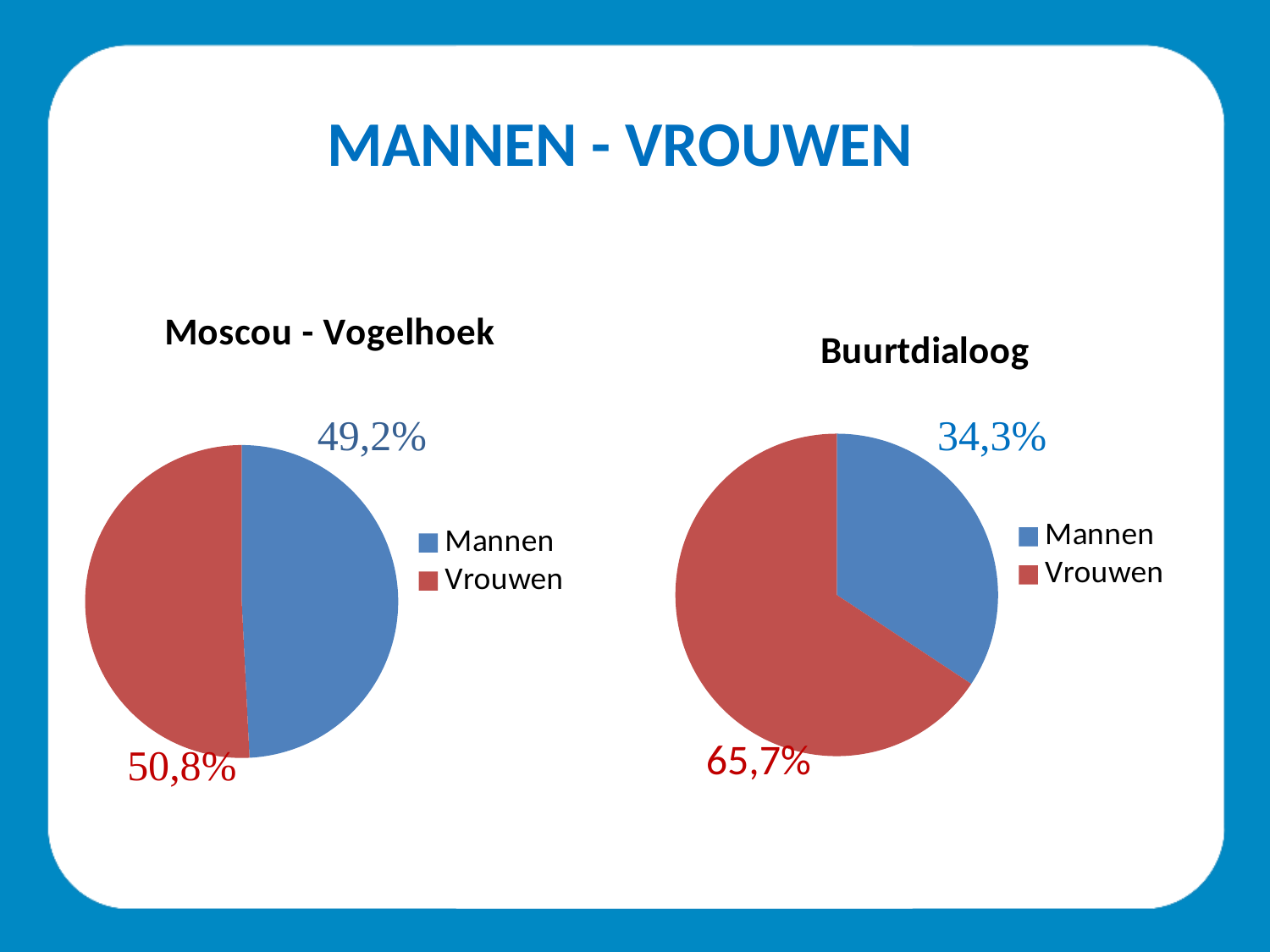
In the 'Buurtdialoog' pie chart, what is the share for Mannen? 34,3% In the 'Moscou - Vogelhoek' pie chart, what is the difference between the Vrouwen and Mannen shares? 1,6% In the 'Buurtdialoog' pie chart, what is the share for Vrouwen? 65,7% In the 'Buurtdialoog' pie chart, which category has the largest slice? Vrouwen In the 'Buurtdialoog' pie chart, what is the difference between the Vrouwen and Mannen shares? 31,4% In the 'Buurtdialoog' pie chart, which colour represents Vrouwen? Red What kind of chart is the 'Buurtdialoog' chart? Pie chart How many categories does the 'Moscou - Vogelhoek' pie chart have? 2 In the 'Buurtdialoog' pie chart, which category has the smallest slice? Mannen In the 'Moscou - Vogelhoek' pie chart, what is the share for Vrouwen? 50,8% Is the Mannen share larger in the 'Moscou - Vogelhoek' chart or in the 'Buurtdialoog' chart? Moscou - Vogelhoek In the 'Moscou - Vogelhoek' pie chart, what is the share for Mannen? 49,2%